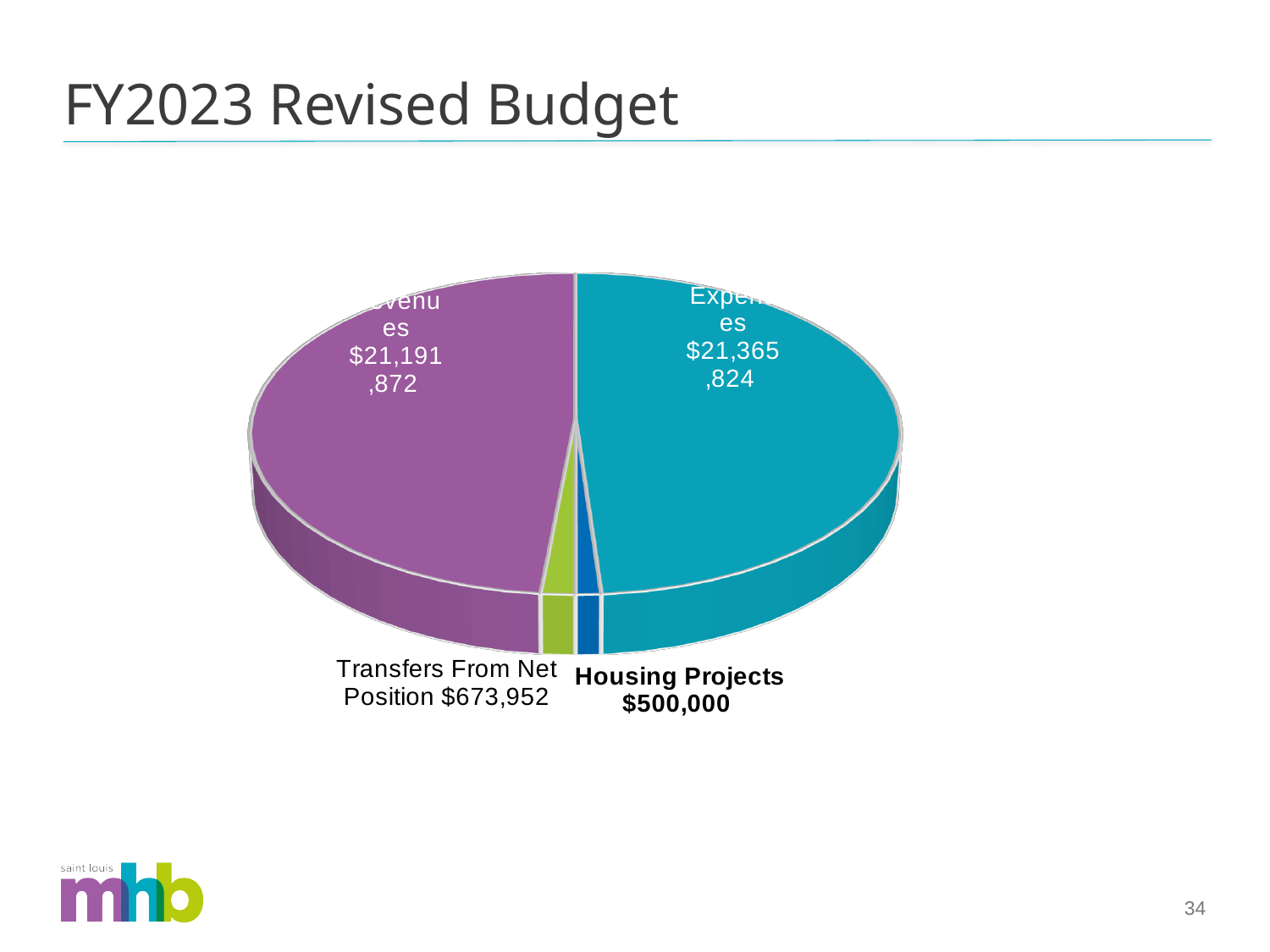
What is the title of the slide containing the chart? FY2023 Revised Budget What is the difference between Expenses and Revenues? $173,952 Which category has the largest value in the pie chart? Expenses What is the value shown for Expenses in the pie chart? $21,365,824 Which category has the smallest value in the pie chart? Housing Projects Which is larger, Transfers From Net Position or Housing Projects? Transfers From Net Position How many slices does the pie chart have? 4 What is the value shown for Transfers From Net Position? $673,952 What is the difference between Transfers From Net Position and Housing Projects? $173,952 What kind of chart is shown on the slide? Pie chart What is the value shown for Revenues in the pie chart? $21,191,872 What is the value shown for Housing Projects? $500,000